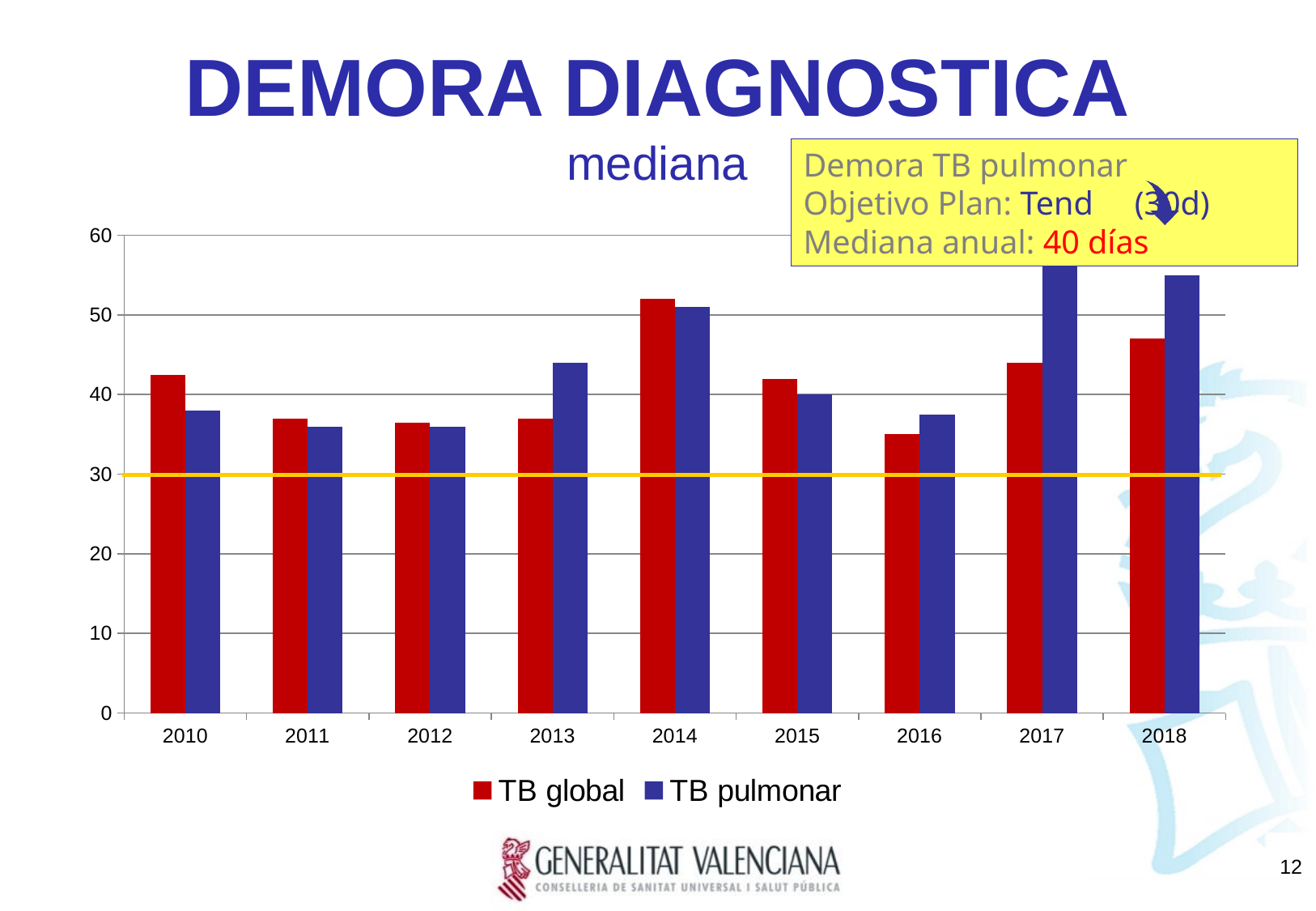
In 2010, which is larger, TB global or TB pulmonar? TB global Is the TB global value for 2014 greater or less than 50? greater What are the two series named in the legend? TB global and TB pulmonar Which year has the highest TB global value? 2014 Is the TB global value for 2016 greater or less than 40? less Is the TB pulmonar value for 2013 greater or less than 40? greater What kind of chart is shown on the slide? bar chart How many years are shown on the x axis? 9 At what value on the y axis is the horizontal yellow line drawn? 30 In 2013, which is larger, TB global or TB pulmonar? TB pulmonar How many series does the legend list? 2